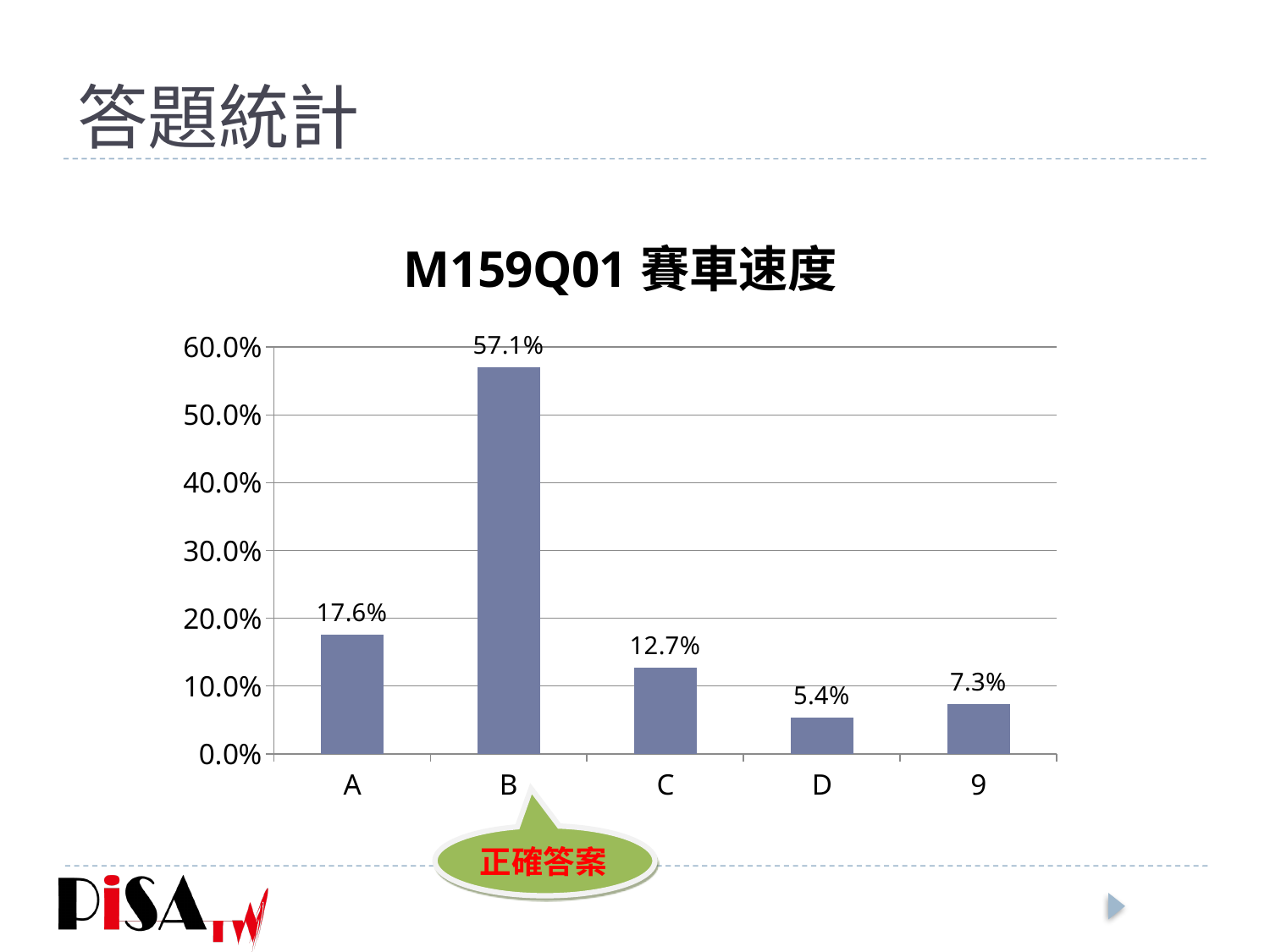
What is the title of the chart? M159Q01 賽車速度 Which category has the lowest value? D What is the value for category 9? 7.3% Which category has the highest value? B What is the value for category B? 57.1% What is the value for category A? 17.6% What is the difference between the values for B and A? 39.5% What is the difference between the values for C and D? 7.3% Which is larger, the value for C or the value for 9? C How many categories are shown on the x axis? 5 What is the value for category D? 5.4% What kind of chart is this? Bar chart